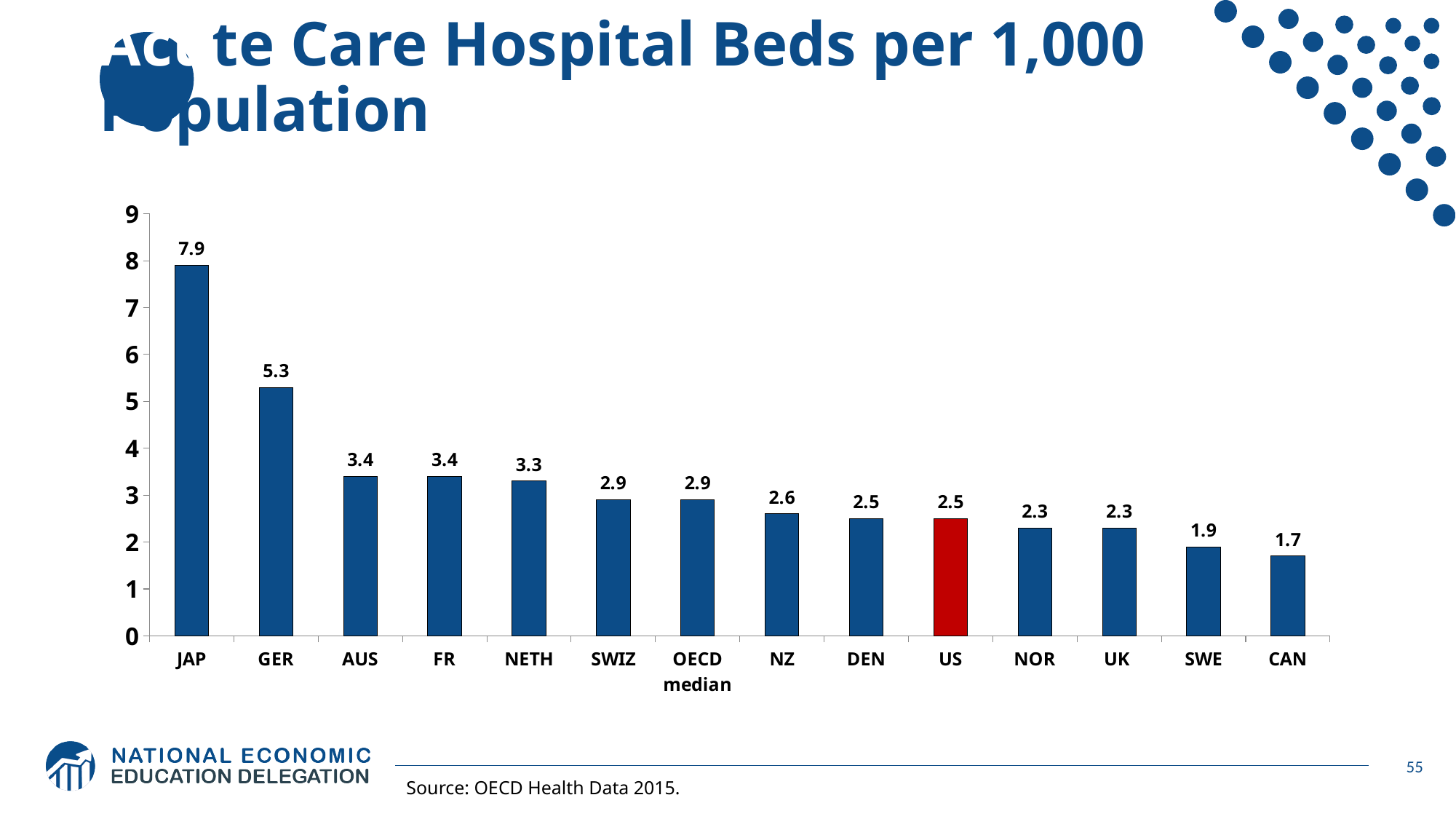
Which category has the highest value? JAP What is the value for US? 2.5 Which is larger, the value for GER or the value for AUS? GER What is the difference between the values for JAP and GER? 2.6 How many categories are shown on the x axis? 14 Is the value for NETH greater or less than 3? greater What is the difference between the values for the OECD median and US? 0.4 What is the value for the OECD median? 2.9 What kind of chart is shown on the slide? bar chart What is the value for JAP? 7.9 Which bar is coloured red? US Which category has the lowest value? CAN